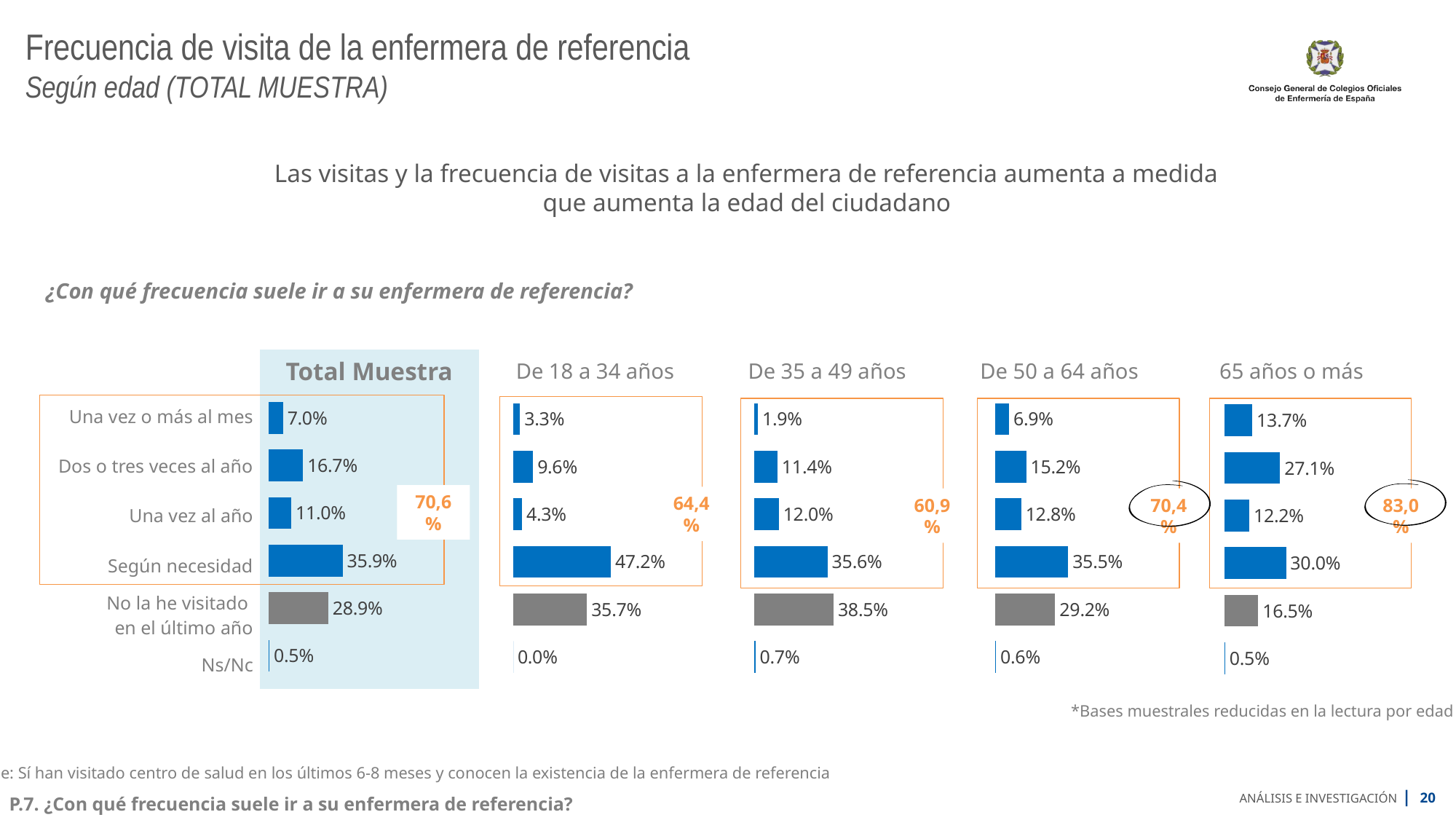
In the 'De 50 a 64 años' chart, what is the difference between 'Dos o tres veces al año' and 'Una vez al año'? 2.4% In the 'De 18 a 34 años' chart, what is the difference between 'Según necesidad' and 'No la he visitado en el último año'? 11.5% In the 'De 50 a 64 años' chart, which category has the lowest value? Ns/Nc In the 'De 35 a 49 años' chart, which category has the highest value? No la he visitado en el último año In the 'De 18 a 34 años' chart, what is the value for 'Una vez o más al mes'? 3.3% In the '65 años o más' chart, which is larger: 'Una vez o más al mes' or 'Una vez al año'? Una vez o más al mes In the '65 años o más' chart, what is the value for 'Dos o tres veces al año'? 27.1% In the 'Total Muestra' chart, what is the value for 'Según necesidad'? 35.9% How many categories does the 'Total Muestra' chart show? 6 In the 'De 35 a 49 años' chart, what is the value for 'Ns/Nc'? 0.7% What kind of chart is used for the 'De 50 a 64 años' data? Bar chart How many separate bar charts are shown on the slide? 5